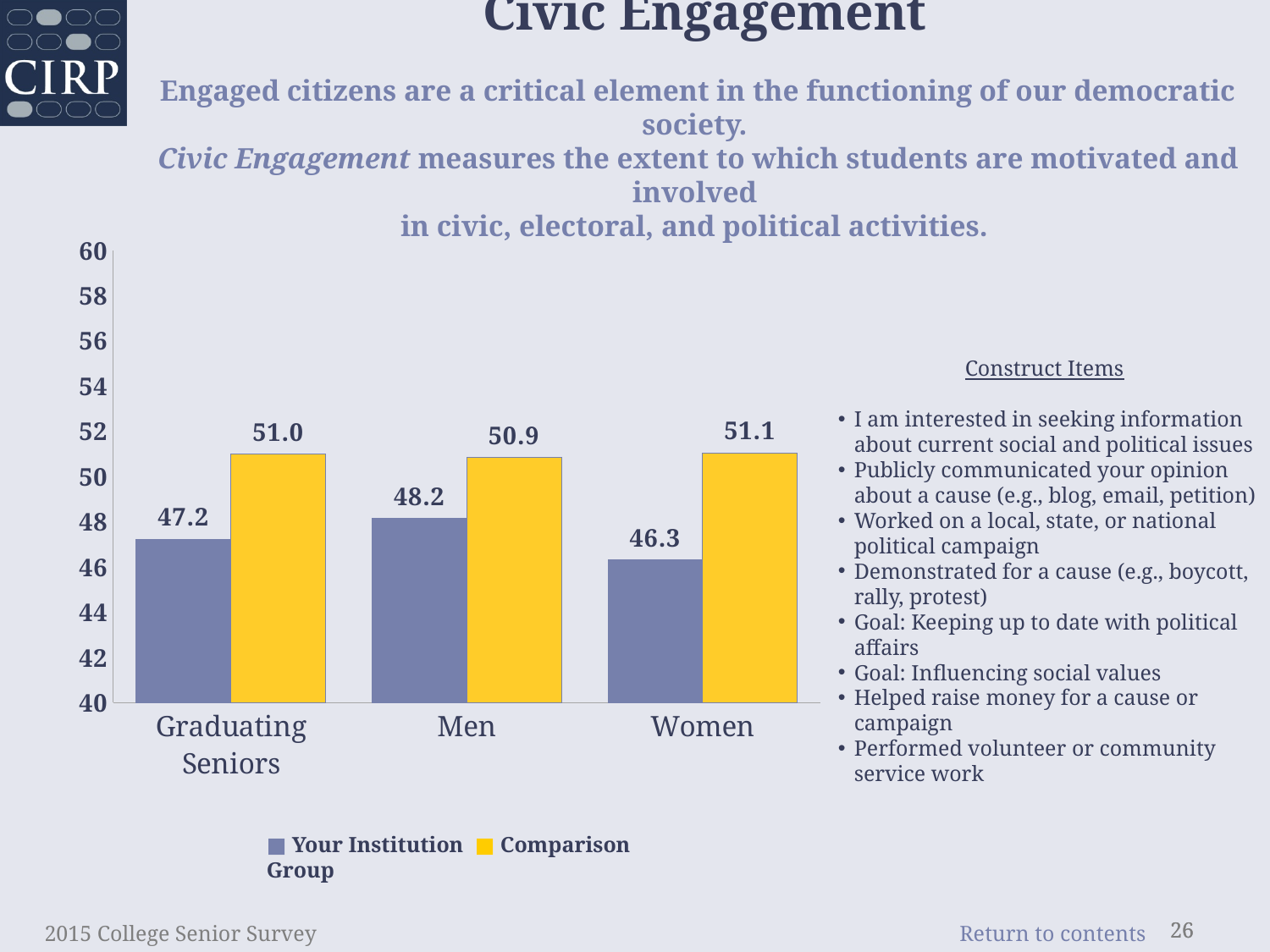
Is the Your Institution value for Women greater or less than 48? less For Men, which is larger: Your Institution or Comparison Group? Comparison Group Which category has the lowest Your Institution value? Women What is the difference between the Comparison Group and Your Institution values for Women? 4.8 What is the difference between the Comparison Group and Your Institution values for Graduating Seniors? 3.8 Which category has the highest Your Institution value? Men What is the Your Institution value for Graduating Seniors? 47.2 What is the Comparison Group value for Men? 50.9 What kind of chart is shown on the slide? bar chart What is the Your Institution value for Women? 46.3 How many categories are shown on the x axis? 3 How many series does the legend list? 2